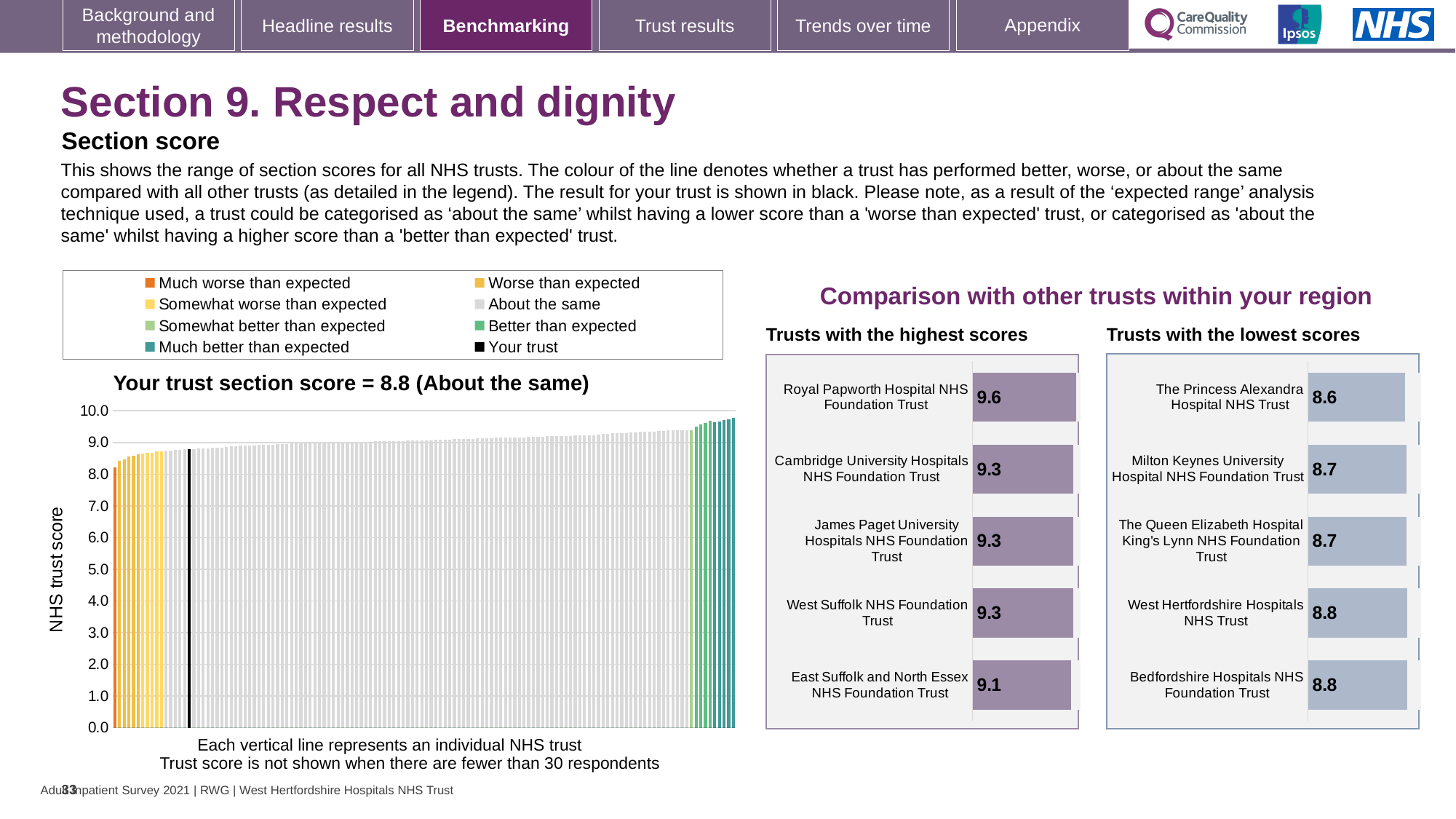
How many trusts are shown in the 'Trusts with the highest scores' chart? 5 Which is larger: the score for West Suffolk NHS Foundation Trust in the 'Trusts with the highest scores' chart or the score for West Hertfordshire Hospitals NHS Trust in the 'Trusts with the lowest scores' chart? West Suffolk NHS Foundation Trust In the 'Trusts with the highest scores' chart, what is the difference between the scores of Royal Papworth Hospital NHS Foundation Trust and East Suffolk and North Essex NHS Foundation Trust? 0.5 In the chart titled 'Your trust section score = 8.8 (About the same)', what is the section score for your trust? 8.8 In the 'Trusts with the highest scores' chart, what is the score for Royal Papworth Hospital NHS Foundation Trust? 9.6 In the 'Trusts with the highest scores' chart, which trust has the highest score? Royal Papworth Hospital NHS Foundation Trust In the 'Trusts with the lowest scores' chart, what is the score for The Princess Alexandra Hospital NHS Trust? 8.6 What kind of chart is the chart titled 'Your trust section score = 8.8 (About the same)'? Bar chart In the 'Trusts with the lowest scores' chart, what is the difference between the scores of Bedfordshire Hospitals NHS Foundation Trust and The Princess Alexandra Hospital NHS Trust? 0.2 In the 'Trusts with the highest scores' chart, what is the score for East Suffolk and North Essex NHS Foundation Trust? 9.1 In the 'Trusts with the lowest scores' chart, what is the score for Milton Keynes University Hospital NHS Foundation Trust? 8.7 In the 'Trusts with the lowest scores' chart, which trust has the lowest score? The Princess Alexandra Hospital NHS Trust